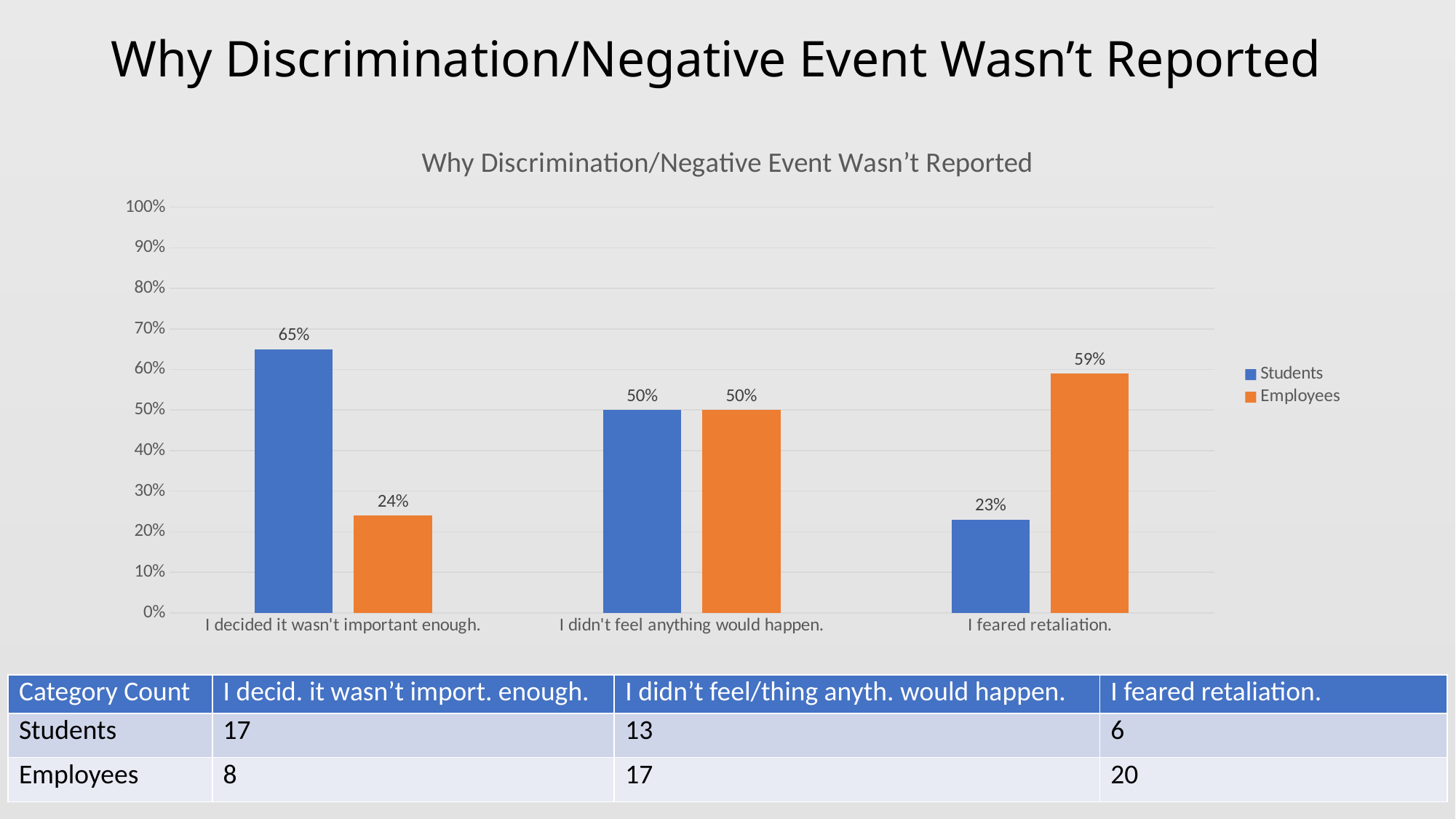
What is the value for Students in the category "I feared retaliation."? 23% Which category has the highest value for Students? I decided it wasn't important enough. What is the value for Employees in the category "I feared retaliation."? 59% What is the value for Employees in the category "I decided it wasn't important enough."? 24% What is the difference between the Students and Employees values in the category "I feared retaliation."? 36% How many series does the chart legend list? 2 Which category has the lowest value for Employees? I decided it wasn't important enough. How many categories are shown on the x axis of the chart? 3 In the category "I decided it wasn't important enough.", which series has the larger value, Students or Employees? Students What colour are the bars for the Employees series? Orange What kind of chart is shown on the slide? Bar chart What is the value for Students in the category "I decided it wasn't important enough."? 65%